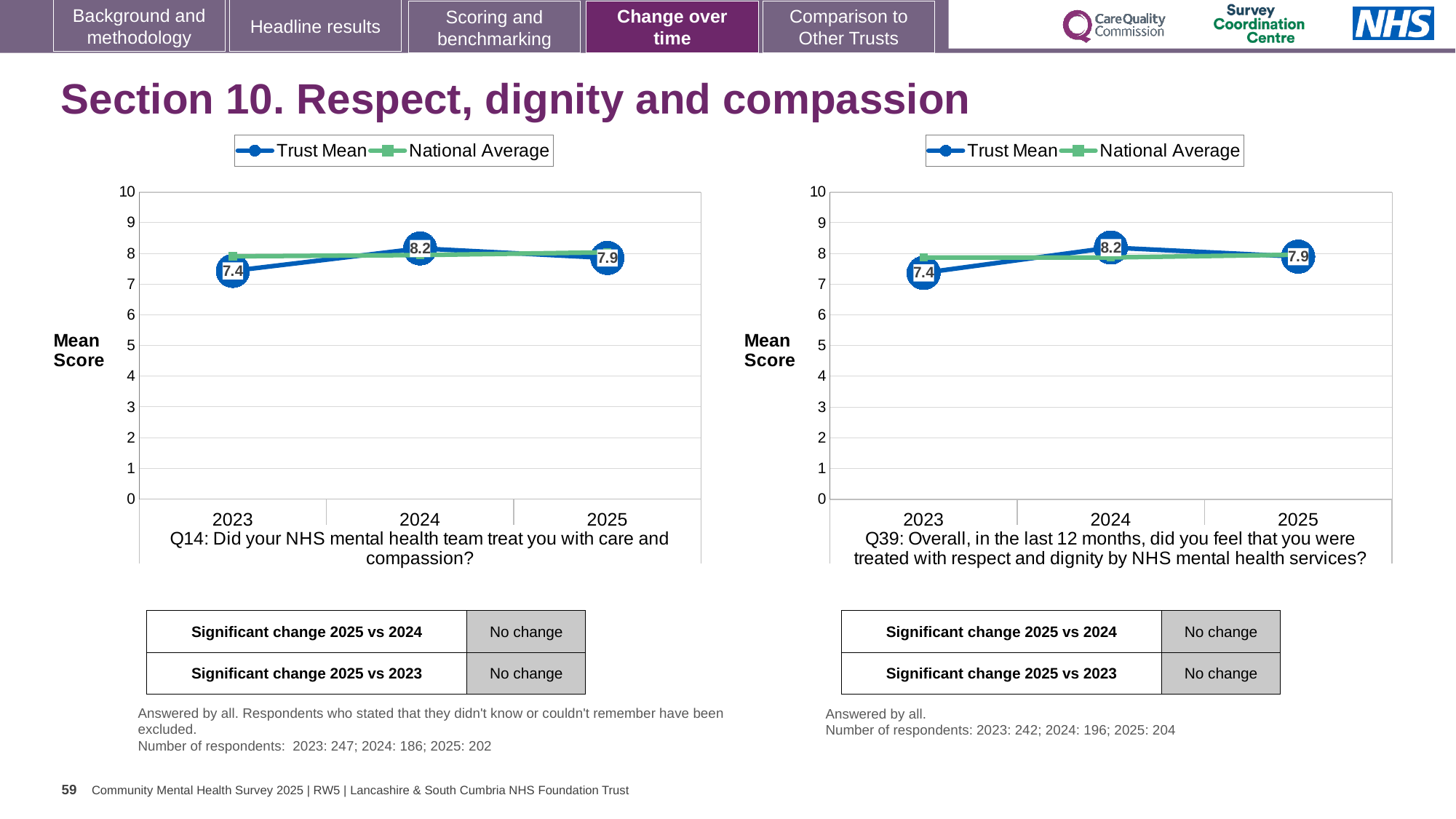
In the Q39 chart on the right, which is larger in 2023: the Trust Mean or the National Average? National Average In the Q14 chart on the left, is the National Average for 2023 greater or less than 7? greater In the Q14 chart on the left, what is the Trust Mean for 2023? 7.4 In the Q14 chart on the left, what is the difference between the Trust Mean for 2024 and the Trust Mean for 2023? 0.8 How many years are plotted on the x axis of the Q39 chart on the right? 3 In the Q39 chart on the right, which year has the highest Trust Mean? 2024 In the Q14 chart on the left, which year has the lowest Trust Mean? 2023 How many series does the legend of the Q14 chart on the left list? 2 What type of chart is the Q14 chart on the left? Line chart In the Q39 chart on the right, what is the Trust Mean for 2025? 7.9 In the Q39 chart on the right, does the Trust Mean rise or fall from 2023 to 2024? Rise In the Q14 chart on the left, what is the Trust Mean for 2024? 8.2